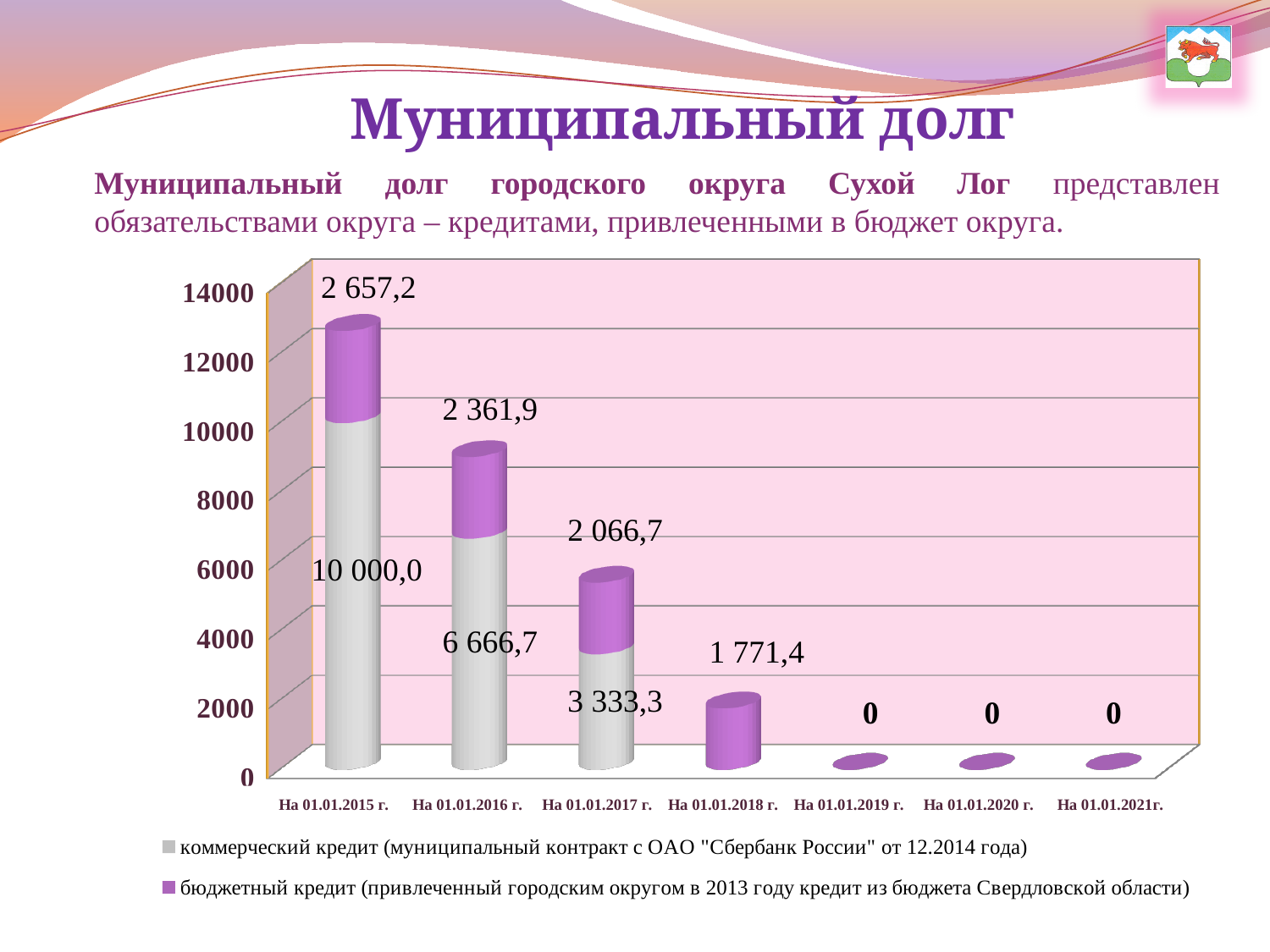
What is the difference between the budget credit values for На 01.01.2015 г. and На 01.01.2016 г.? 295,3 How many dates (categories) are shown on the x axis? 7 What is the difference between the commercial credit values for На 01.01.2016 г. and На 01.01.2017 г.? 3 333,4 Which date has the highest commercial credit (коммерческий кредит) value? На 01.01.2015 г. What is the value shown for На 01.01.2020 г.? 0 What is the total of the stacked bar for На 01.01.2015 г.? 12 657,2 What is the value of the budget credit (бюджетный кредит) series for На 01.01.2018 г.? 1 771,4 How many series does the legend list? 2 What is the value of the commercial credit (коммерческий кредит) series for На 01.01.2015 г.? 10 000,0 Do the values rise or fall from На 01.01.2015 г. to На 01.01.2021 г.? fall Which is larger: the commercial credit value for На 01.01.2016 г. or the budget credit value for На 01.01.2016 г.? commercial credit (6 666,7) What is the value of the budget credit (бюджетный кредит) series for На 01.01.2017 г.? 2 066,7